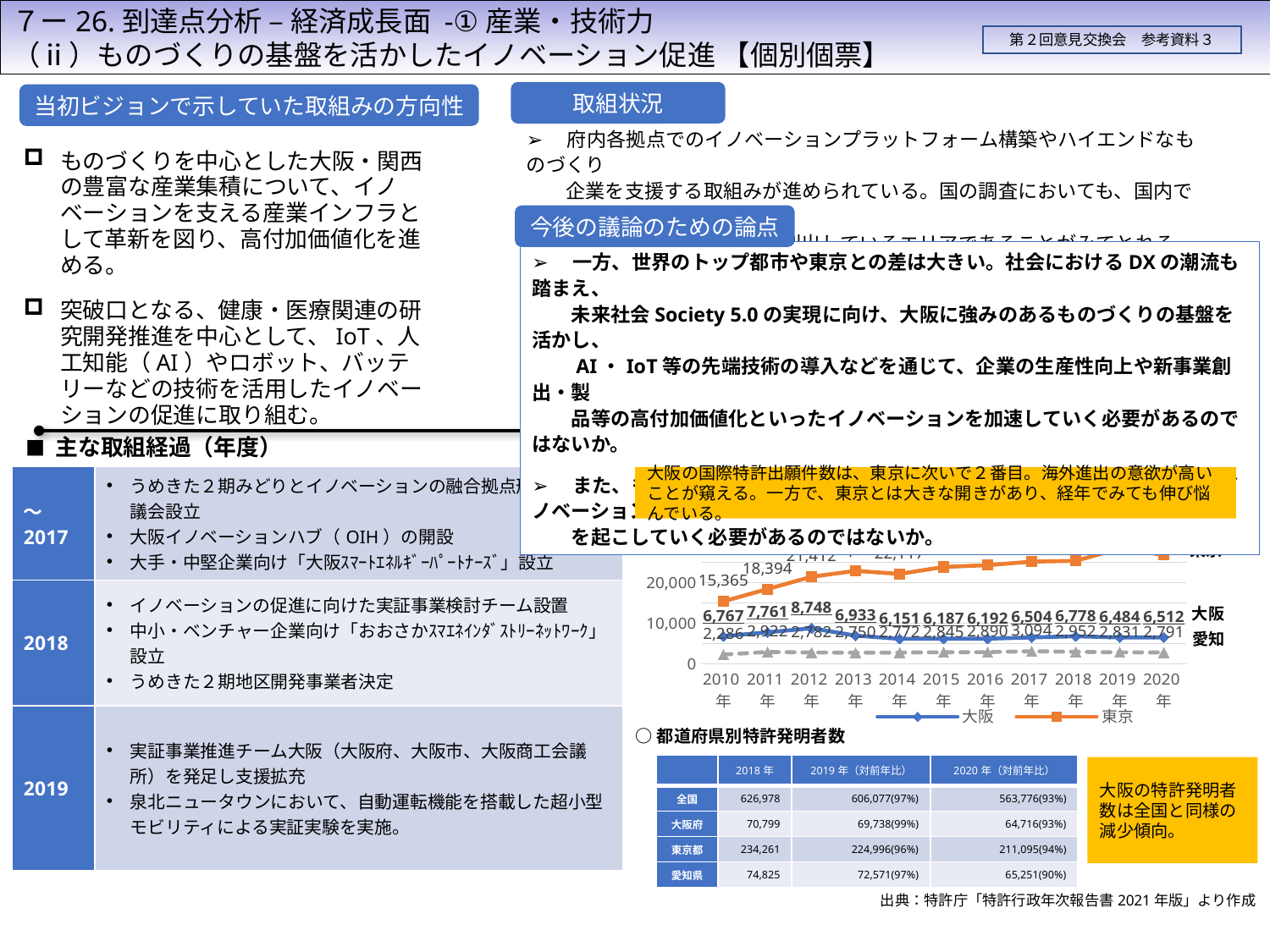
In the line chart, in which year is the value for 大阪 highest? 2012年 In the line chart, what is the value for 東京 in 2010年? 15,365 In the line chart, what is the value for 大阪 in 2012年? 8,748 In the line chart, what is the difference between the 東京 values for 2011年 and 2010年? 3,029 What kind of chart is shown on the slide? line chart In the line chart, what is the difference between the 大阪 values for 2012年 and 2013年? 1,815 In the line chart, is the value for 東京 in 2020年 greater or less than 20,000? greater In the line chart, what is the value for 愛知 in 2017年? 3,094 In the line chart, what is the value for 愛知 in 2010年? 2,286 In the line chart, in which year is the value for 愛知 highest? 2017年 How many years are plotted on the x axis of the line chart? 11 In the line chart, which is larger in 2010年, the value for 大阪 or the value for 愛知? 大阪